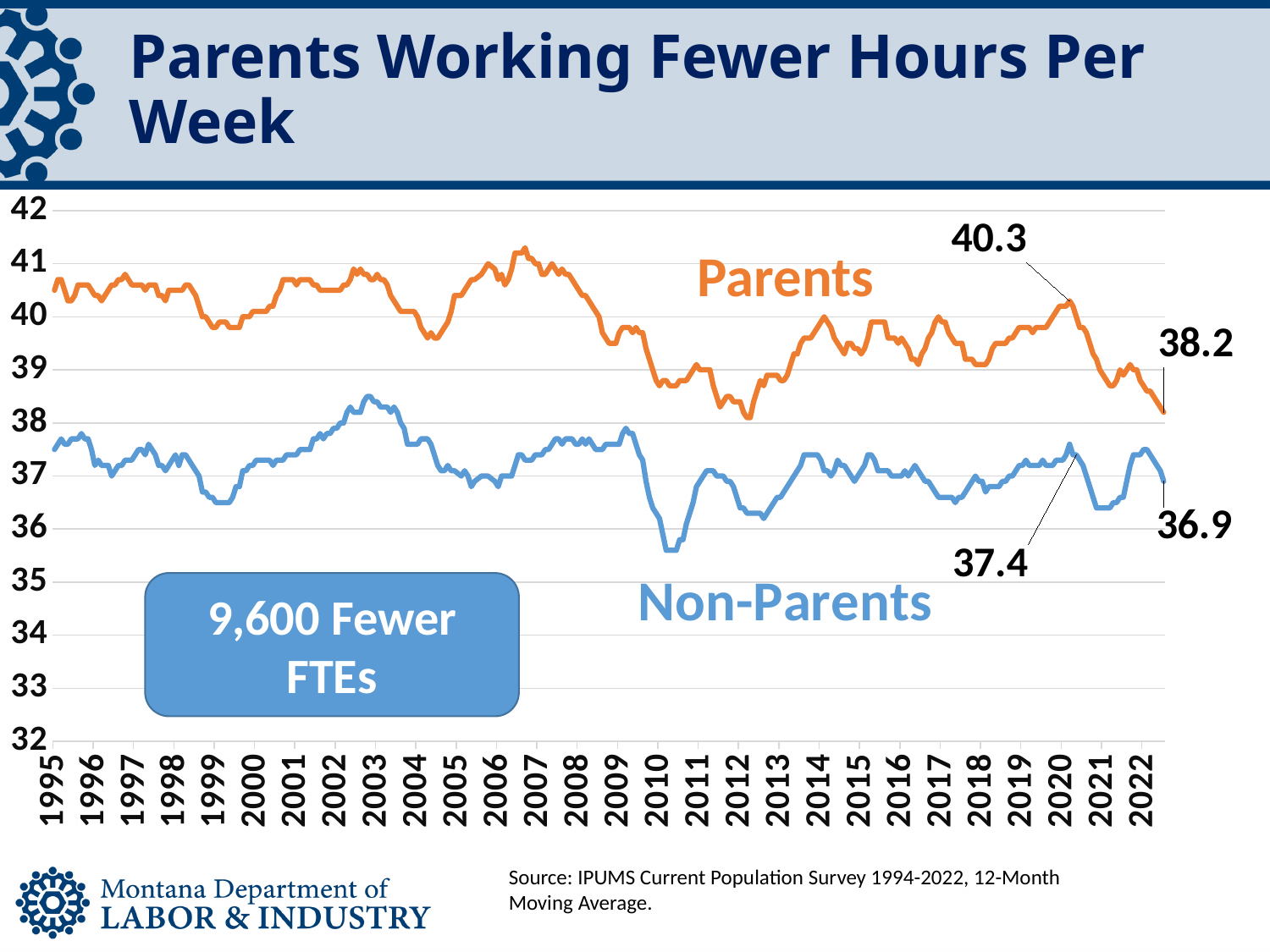
What is the labelled value for Non-Parents around 2020? 37.4 At the end of the series in 2022, which line is higher, Parents or Non-Parents? Parents What is the labelled value for Non-Parents at the end of the series in 2022? 36.9 What is the difference between the labelled Non-Parents values 37.4 and 36.9? 0.5 What is the labelled peak value for Parents around 2020? 40.3 How many series are plotted on the chart? 2 What kind of chart is shown on the slide? Line chart What is the difference between the final labelled values for Parents (38.2) and Non-Parents (36.9)? 1.3 By how much did the Parents value fall from the labelled 40.3 to the labelled 38.2? 2.1 Does the Parents line rise or fall between 2020 and 2022? Fall Is the Non-Parents value at its low point around 2010 greater or less than 36? less What is the labelled value for Parents at the end of the series in 2022? 38.2